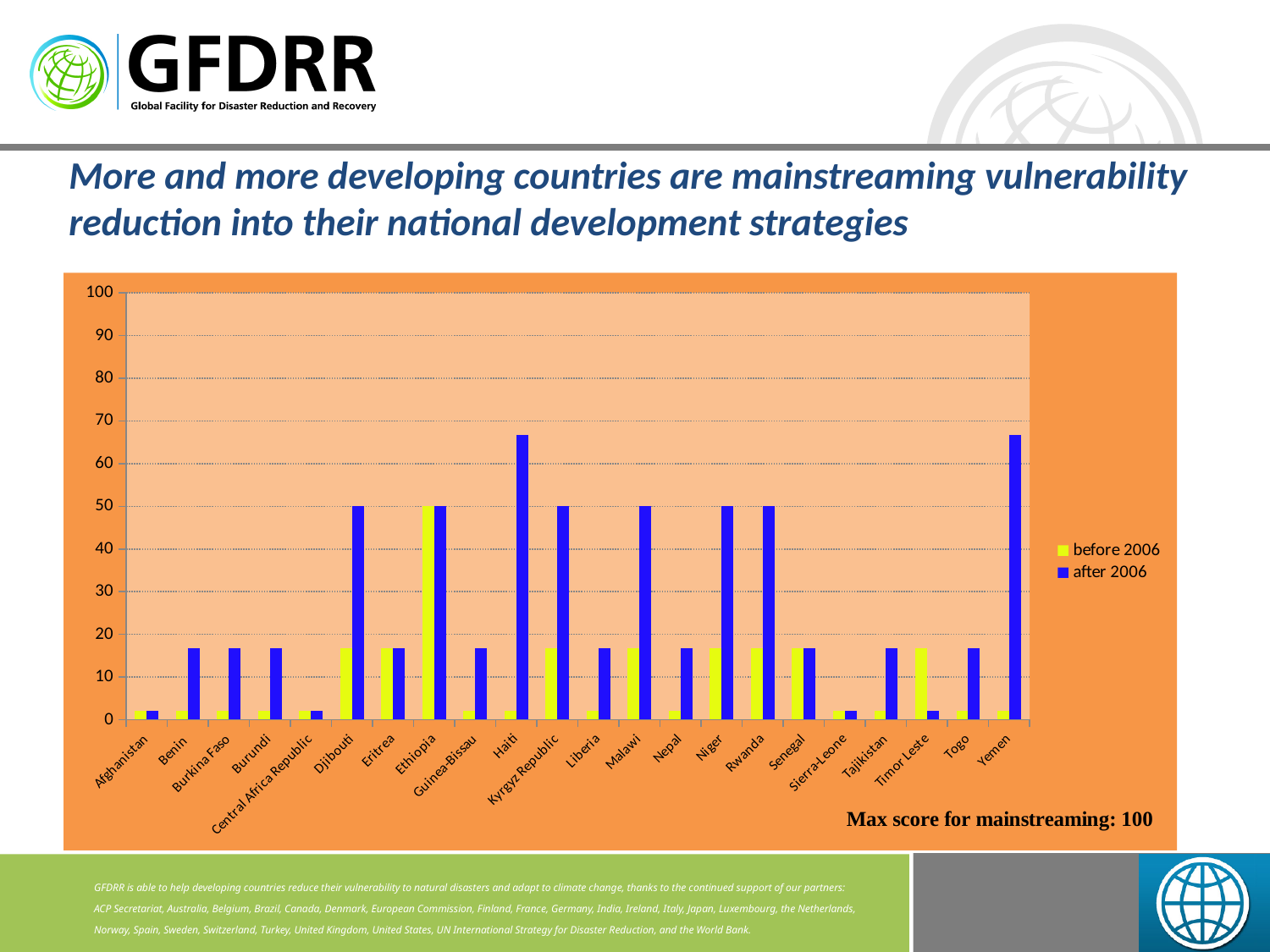
Which is larger: the 'after 2006' value for Haiti or the 'after 2006' value for Benin? Haiti What are the two series named in the chart's legend? before 2006 and after 2006 How many series does the chart's legend list? 2 How many countries are shown on the x axis of the chart? 22 Is the 'after 2006' value for Afghanistan greater or less than 10? less Is the 'before 2006' value for Ethiopia greater or less than 40? greater Is the 'after 2006' value for Djibouti greater or less than 40? greater According to the note below the chart, what is the maximum score for mainstreaming? 100 What kind of chart is shown on the slide? bar chart Which is larger: the 'before 2006' value for Ethiopia or the 'before 2006' value for Eritrea? Ethiopia